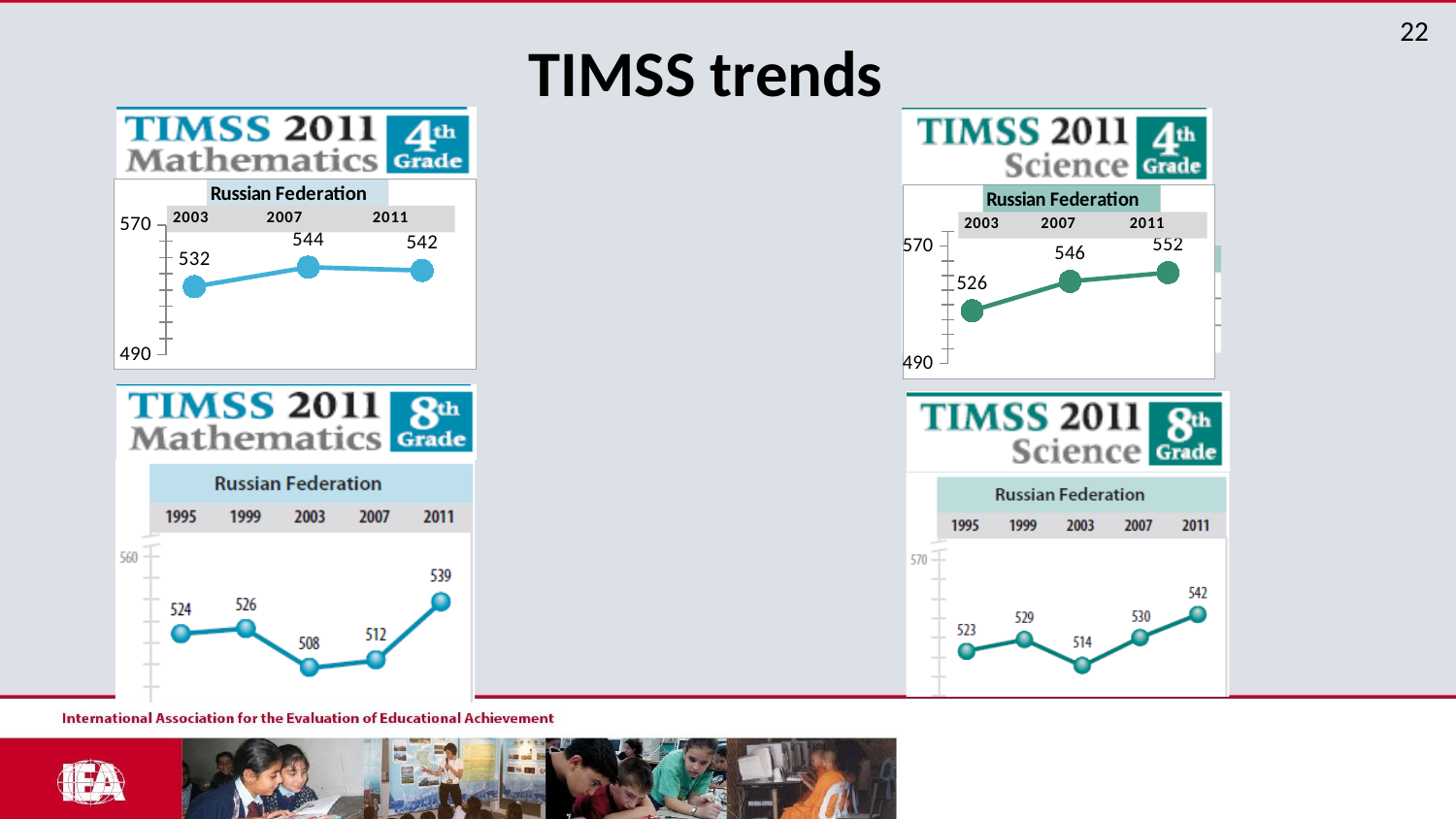
Which country do all four charts on the slide show data for? Russian Federation In the TIMSS 2011 Mathematics 4th Grade chart, what is the value for 2007? 544 In the TIMSS 2011 Science 4th Grade chart, what is the difference between the 2011 value and the 2003 value? 26 In the TIMSS 2011 Mathematics 8th Grade chart, how many years are plotted? 5 In the TIMSS 2011 Mathematics 8th Grade chart, what is the difference between the 2011 value and the 2007 value? 27 In the TIMSS 2011 Mathematics 8th Grade chart, which year has the lowest value? 2003 In the TIMSS 2011 Mathematics 4th Grade chart, which is larger, the value for 2007 or the value for 2011? 2007 In the TIMSS 2011 Science 8th Grade chart, which year has the highest value? 2011 In the TIMSS 2011 Science 4th Grade chart, do the values rise or fall from 2003 to 2011? Rise In the TIMSS 2011 Science 4th Grade chart, what is the value for 2011? 552 In the TIMSS 2011 Science 4th Grade chart, how many data points are plotted? 3 What kind of chart is the TIMSS 2011 Science 8th Grade chart? Line chart